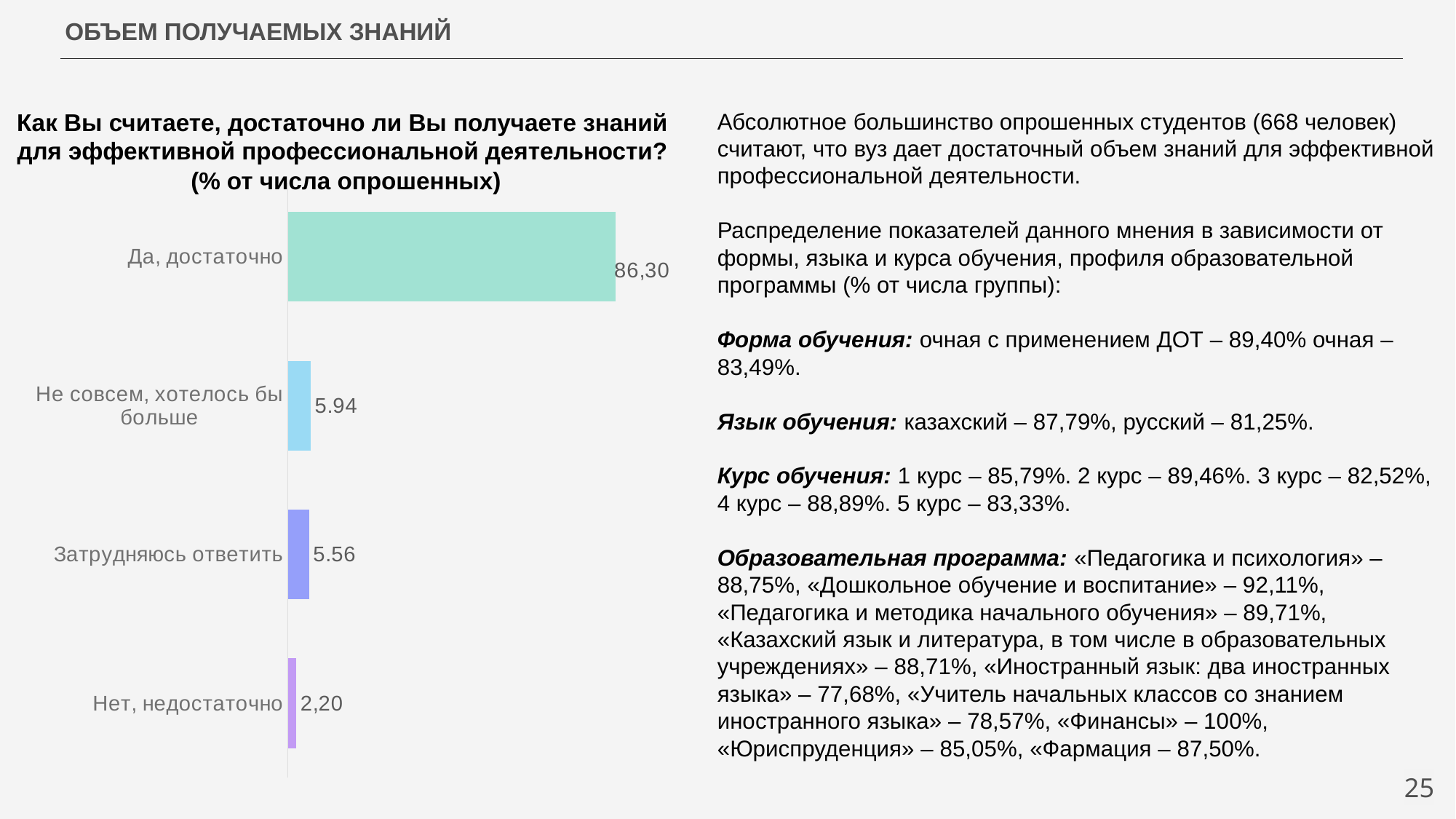
What colour is the bar for "Да, достаточно"? Light green (teal) What is the value for "Не совсем, хотелось бы больше"? 5.94 What is the value for "Затрудняюсь ответить"? 5.56 What type of chart is shown on the slide? Bar chart Which category has the lowest value? Нет, недостаточно What is the difference between the values for "Да, достаточно" and "Нет, недостаточно"? 84,10 What is the difference between the values for "Не совсем, хотелось бы больше" and "Затрудняюсь ответить"? 0.38 Which category has the highest value? Да, достаточно How many categories are shown in the chart? 4 What is the value for "Да, достаточно"? 86,30 What is the value for "Нет, недостаточно"? 2,20 Which is larger: the value for "Не совсем, хотелось бы больше" or for "Затрудняюсь ответить"? Не совсем, хотелось бы больше